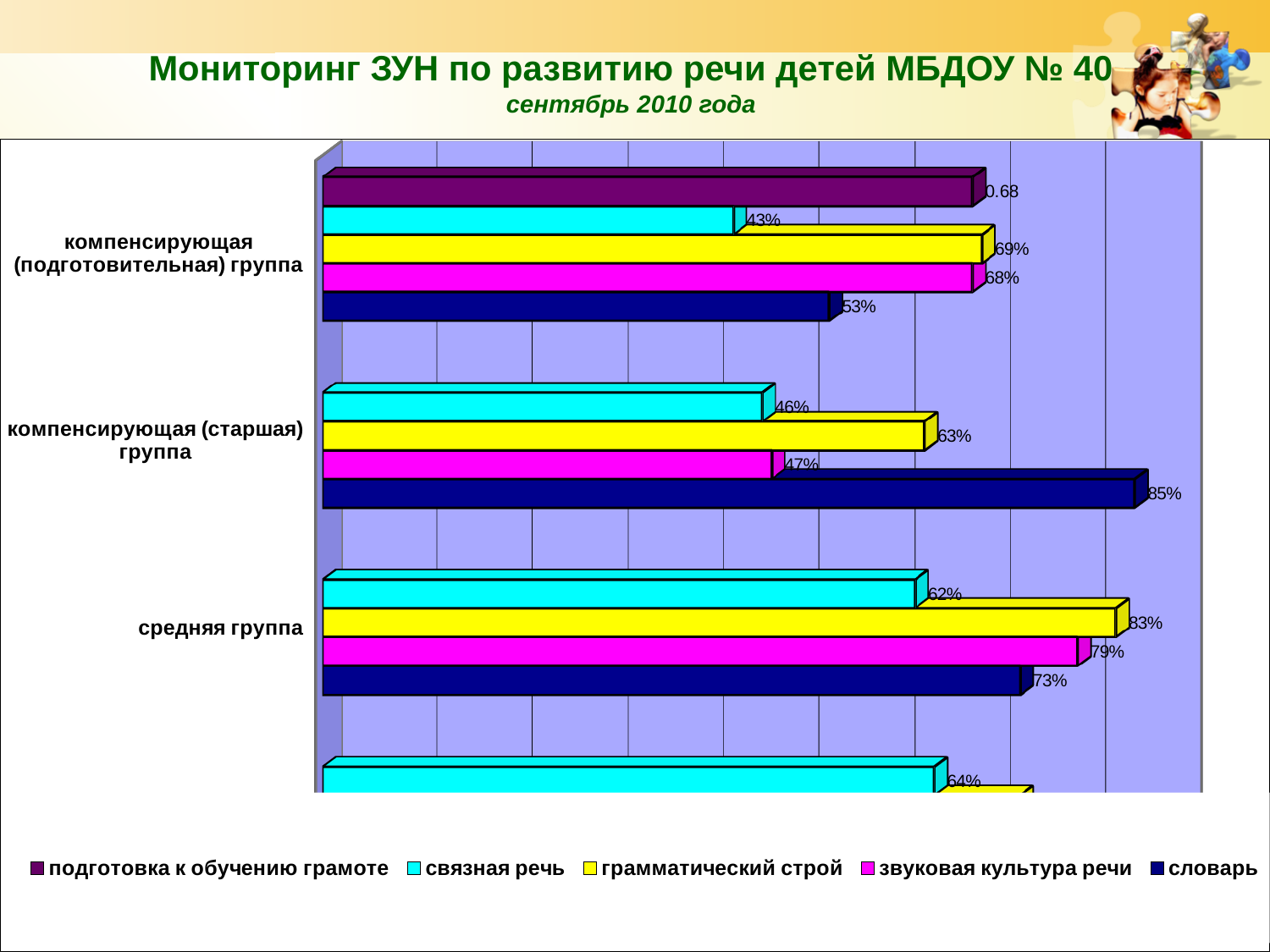
Which group has the highest value for словарь? компенсирующая (старшая) группа What is the difference between the словарь values for компенсирующая (старшая) группа and компенсирующая (подготовительная) группа? 32% What is the value of грамматический строй for средняя группа? 83% What kind of chart is shown on the slide? bar chart Which series has the lowest value for компенсирующая (подготовительная) группа? связная речь What value is labelled on the подготовка к обучению грамоте bar for компенсирующая (подготовительная) группа? 0.68 What is the value of связная речь for компенсирующая (подготовительная) группа? 43% Which series has the highest value for средняя группа? грамматический строй How many series does the legend list? 5 What is the difference between the грамматический строй values for средняя группа and компенсирующая (старшая) группа? 20% Which group has the larger value for звуковая культура речи: средняя группа or компенсирующая (старшая) группа? средняя группа What is the value of словарь for компенсирующая (старшая) группа? 85%